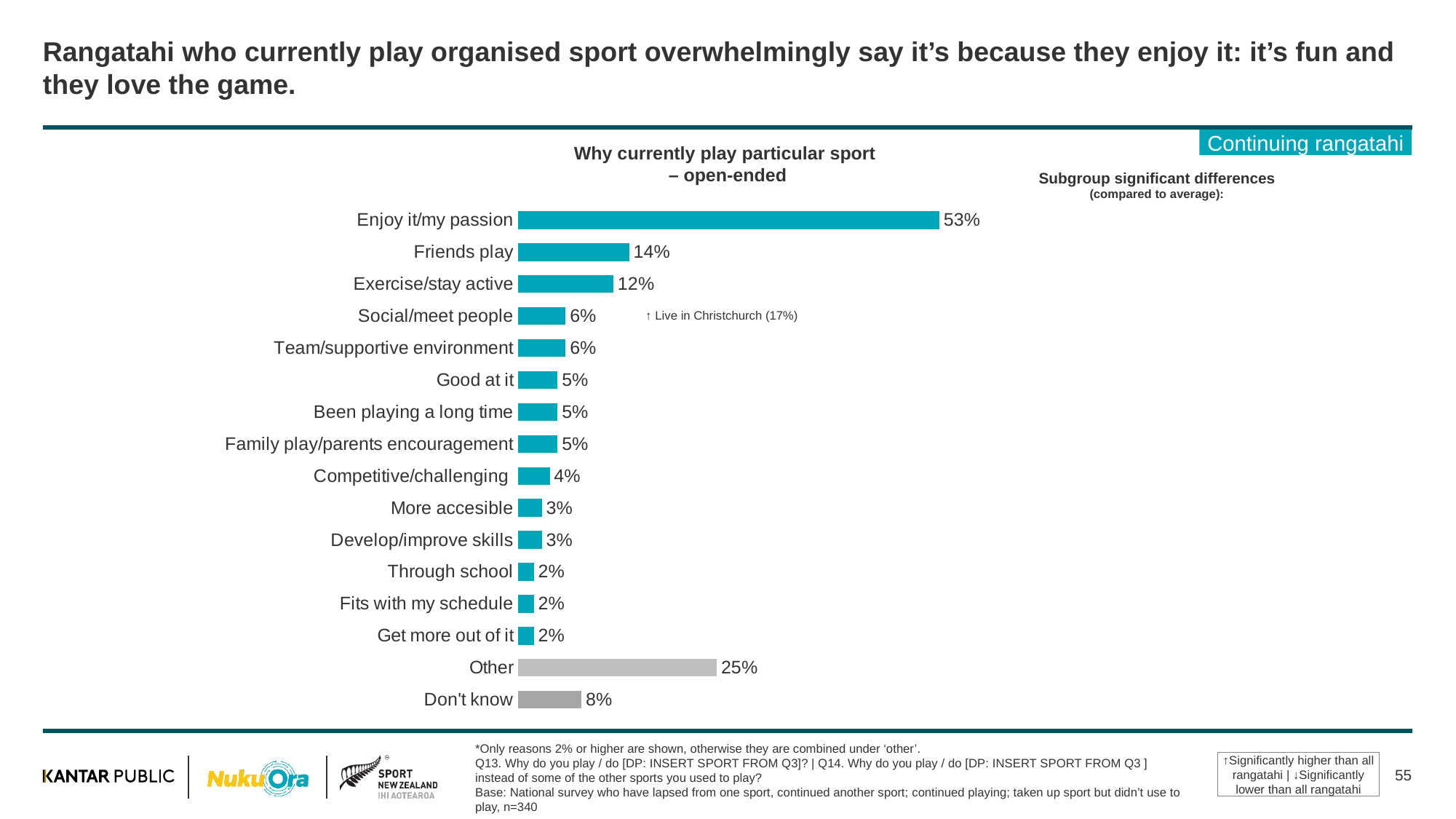
How many categories are shown in the chart? 16 Which is larger, the value for 'Other' or the value for 'Friends play'? Other What percentage is shown for 'Exercise/stay active'? 12% What type of chart is shown on the slide? Bar chart What is the difference between 'Other' and 'Don't know'? 17% What is the title of the chart? Why currently play particular sport – open-ended What is the value shown for 'Friends play'? 14% What is the value for 'Don't know'? 8% Which reason has the highest percentage in the chart? Enjoy it/my passion Which subgroup is noted as significantly higher for 'Social/meet people', and at what value? Live in Christchurch (17%) What percentage of rangatahi say they currently play their sport because they enjoy it/it's their passion? 53% What is the difference in percentage points between 'Enjoy it/my passion' and 'Friends play'? 39